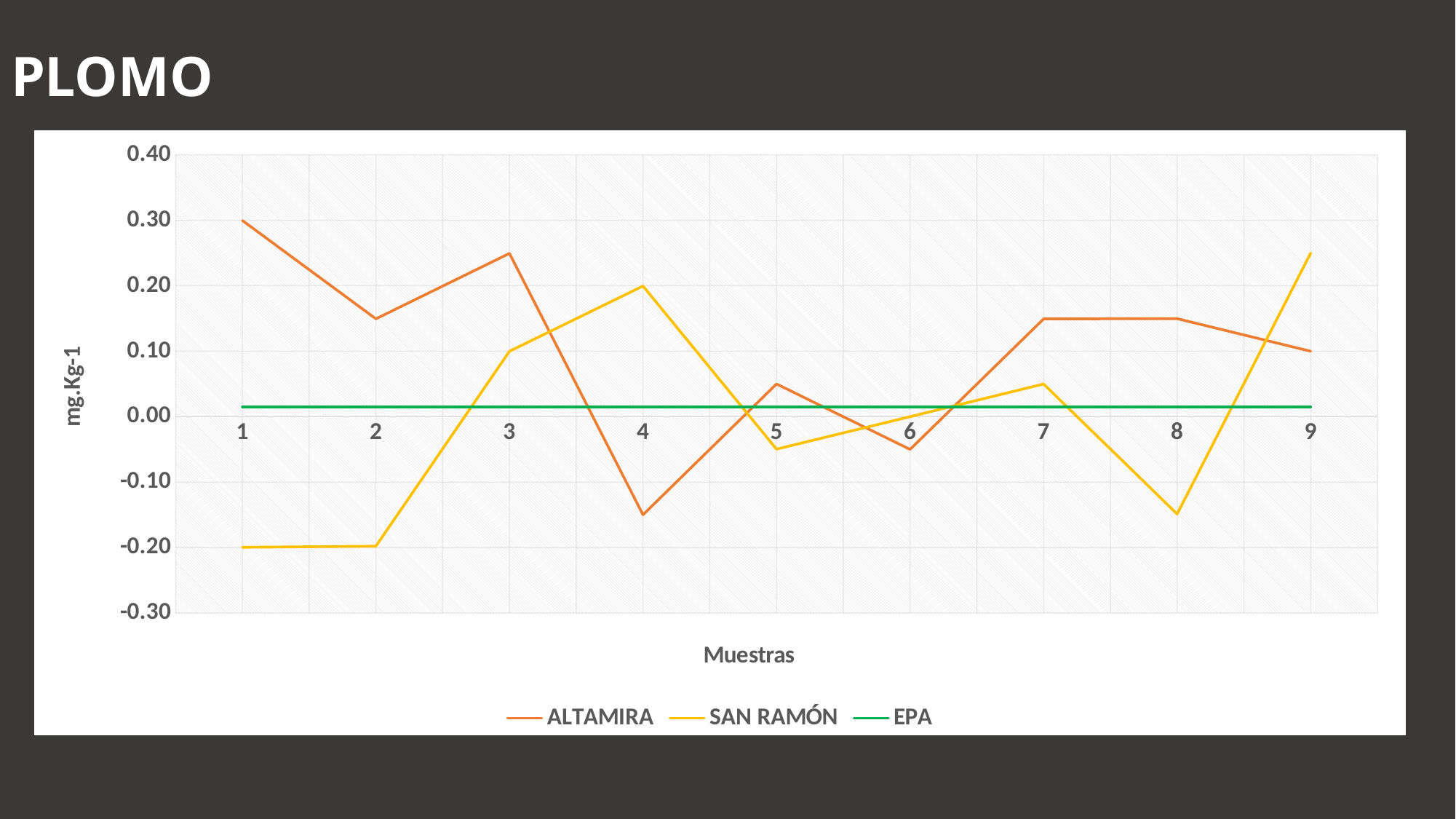
What is the SAN RAMÓN value at sample 4? 0.20 What type of chart is shown on the slide? Line chart How many samples (Muestras) are plotted along the x axis? 9 At which sample does the ALTAMIRA series reach its highest value? 1 At which sample does the SAN RAMÓN series reach its highest value? 9 At which sample does the ALTAMIRA series reach its lowest value? 4 How many series does the legend list? 3 At sample 4, which series has the higher value, ALTAMIRA or SAN RAMÓN? SAN RAMÓN Is the ALTAMIRA value at sample 4 greater or less than -0.10? less What is the ALTAMIRA value at sample 1? 0.30 What is the SAN RAMÓN value at sample 1? -0.20 What is the label on the y axis? mg.Kg-1